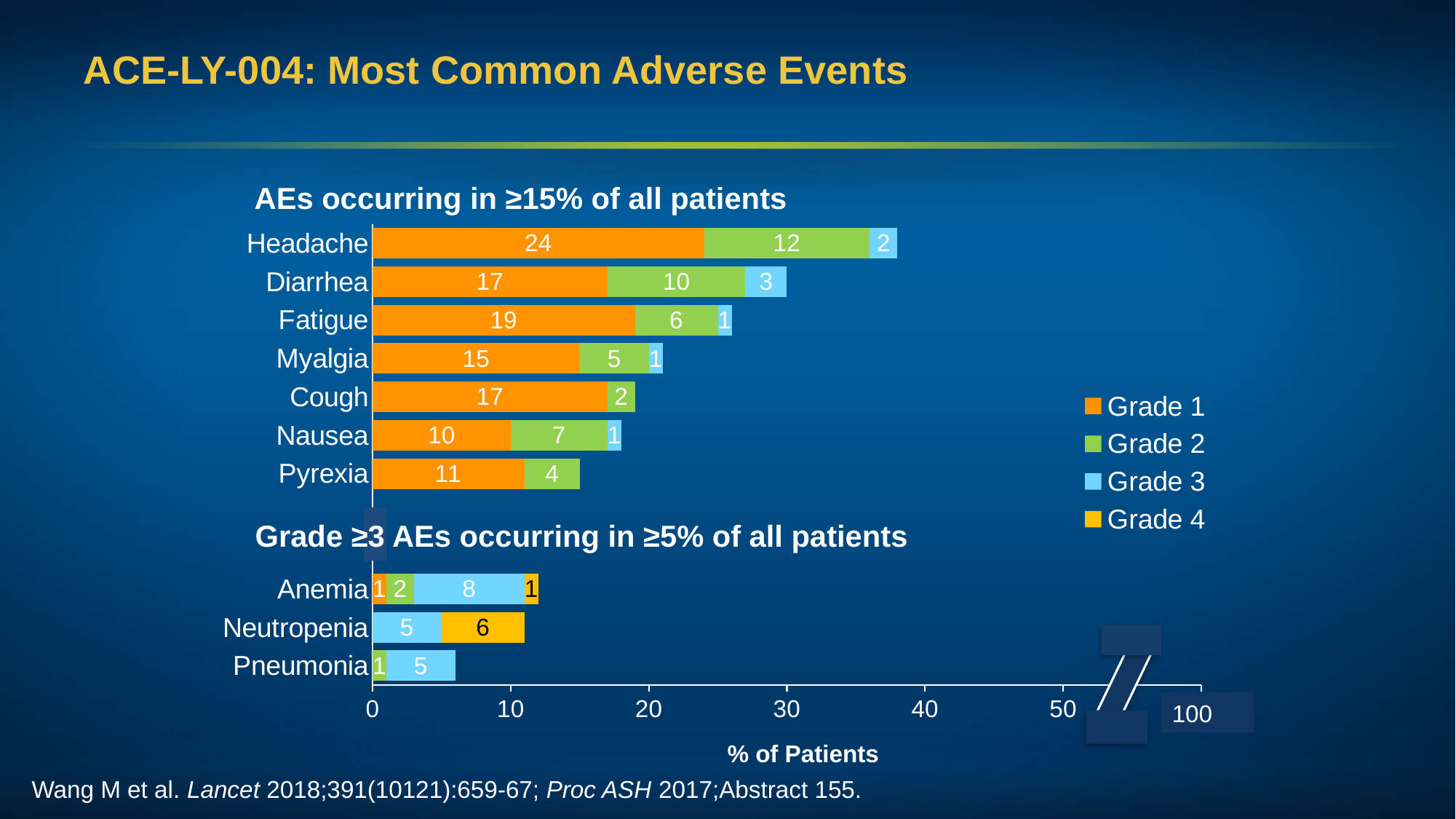
What kind of chart is shown on the slide? Stacked bar chart What is the Grade 2 value for Nausea? 7 What is the Grade 3 value for Diarrhea? 3 Which adverse event has the lowest total bar? Pneumonia Which adverse event has the highest total bar? Headache What is the Grade 4 value for Neutropenia? 6 What is the Grade 1 value for Headache? 24 What is the total stacked value for Headache? 38 Which is larger, the Grade 2 value for Diarrhea or the Grade 2 value for Fatigue? Diarrhea What is the total stacked value for Anemia? 12 What is the difference between the Grade 1 values for Fatigue and Myalgia? 4 How many series does the legend list? 4